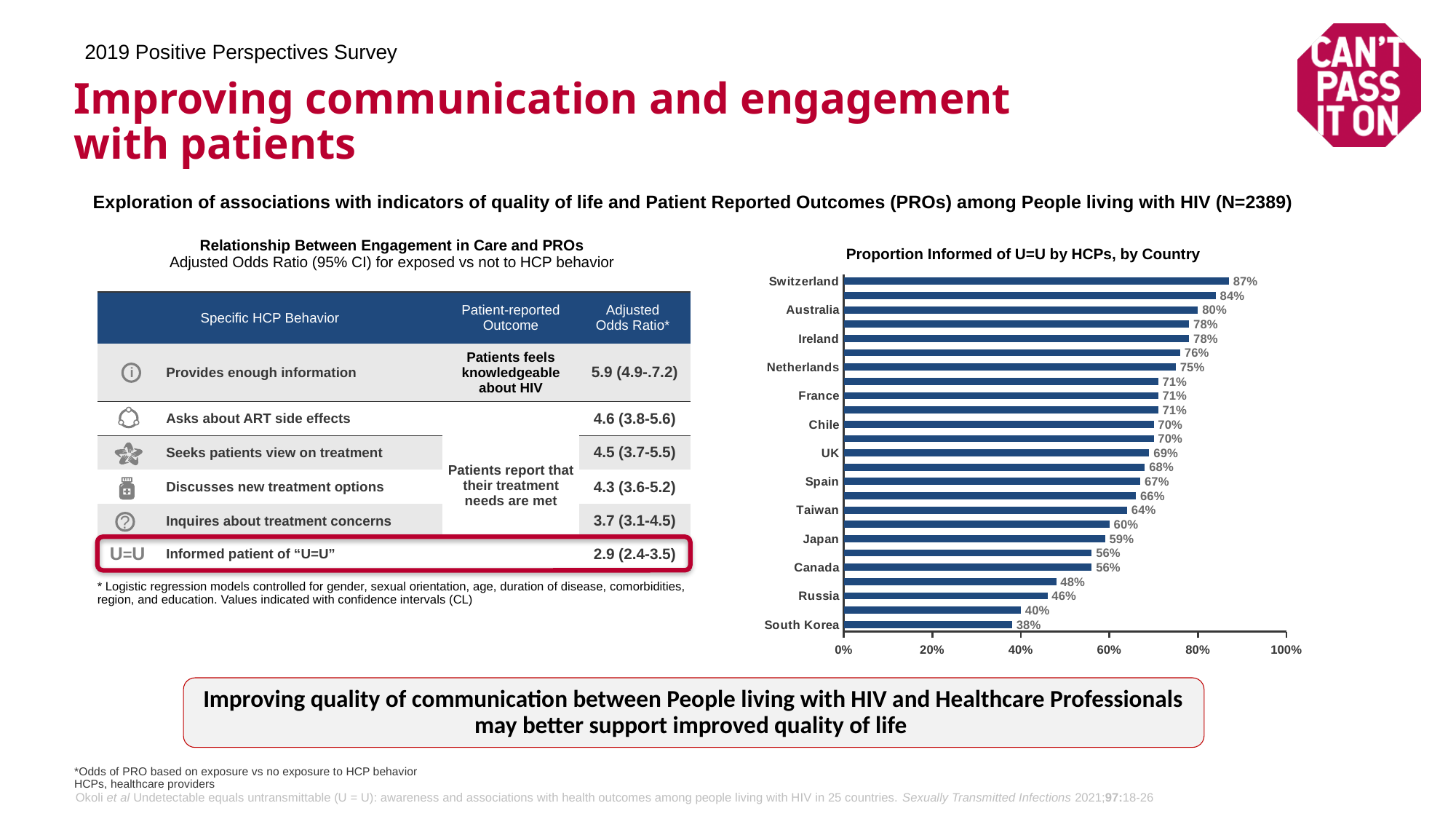
What is the value for the Netherlands in the 'Proportion Informed of U=U by HCPs, by Country' chart? 75% In the 'Proportion Informed of U=U by HCPs, by Country' chart, do the values increase or decrease going from the top bar to the bottom bar? Decrease In the 'Proportion Informed of U=U by HCPs, by Country' chart, what is the difference between the values for Switzerland and South Korea? 49 percentage points What is the value for Japan in the 'Proportion Informed of U=U by HCPs, by Country' chart? 59% What is the value for the UK in the 'Proportion Informed of U=U by HCPs, by Country' chart? 69% Which country has the highest value in the 'Proportion Informed of U=U by HCPs, by Country' chart? Switzerland Which country has the lowest value in the 'Proportion Informed of U=U by HCPs, by Country' chart? South Korea In the 'Proportion Informed of U=U by HCPs, by Country' chart, which is larger: the value for Australia or the value for Canada? Australia What is the title of the bar chart on the right side of the slide? Proportion Informed of U=U by HCPs, by Country What kind of chart is 'Proportion Informed of U=U by HCPs, by Country'? Bar chart What is the value for South Korea in the 'Proportion Informed of U=U by HCPs, by Country' chart? 38% What is the value for Switzerland in the 'Proportion Informed of U=U by HCPs, by Country' chart? 87%